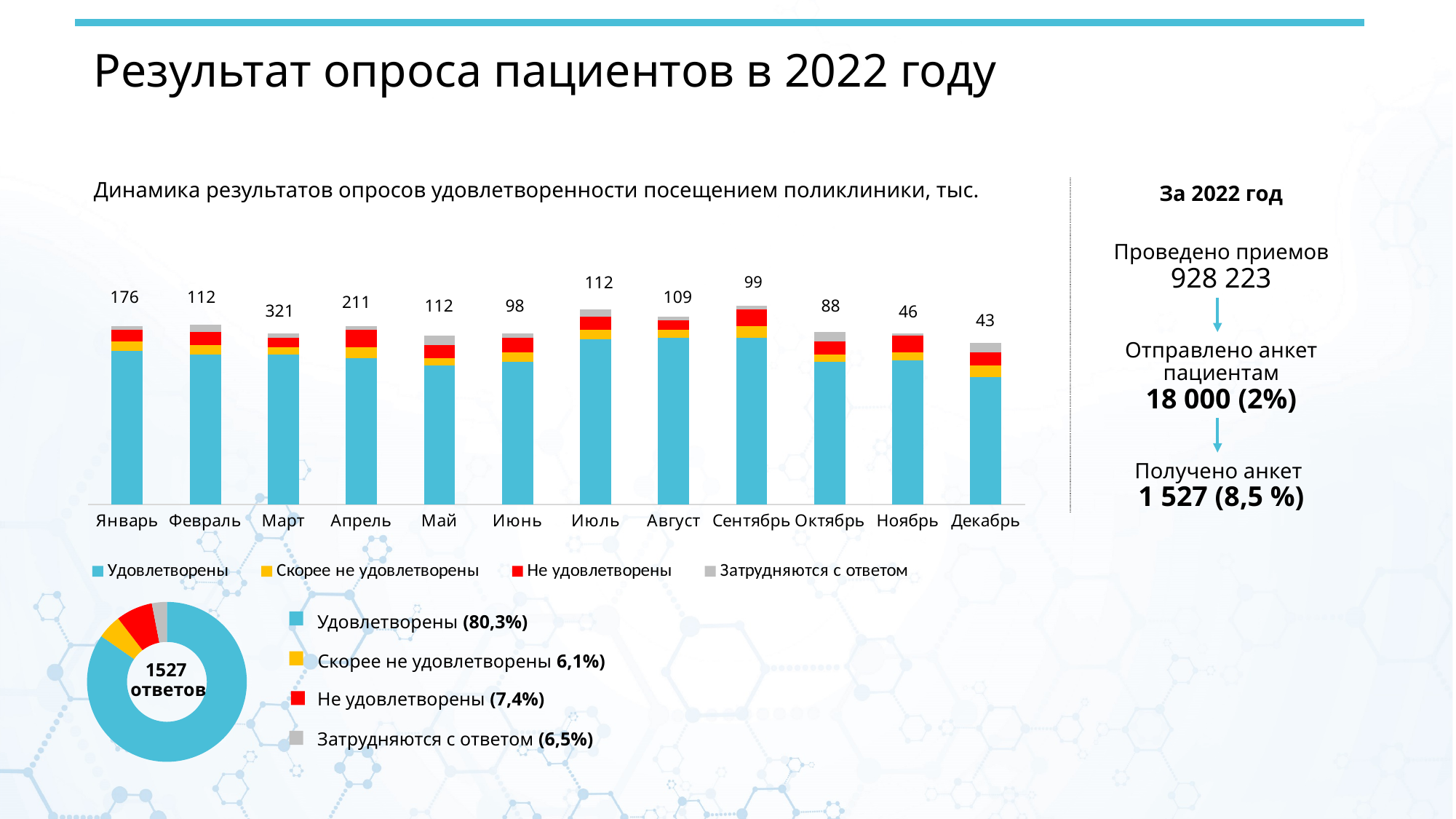
In the donut chart, what share is shown for Удовлетворены? 80,3% In the bar chart, what number is printed above the bar for Сентябрь? 99 How many months are shown on the x axis of the bar chart? 12 In the bar chart, which month has the lowest number printed above its bar? Декабрь In the bar chart, which month has the highest number printed above its bar? Март In the bar chart, what number is printed above the bar for Декабрь? 43 In the bar chart, what number is printed above the bar for Март? 321 In the bar chart, what is the difference between the numbers printed above the bars for Январь and Февраль? 64 In the donut chart, what share is shown for Не удовлетворены? 7,4% What kind of chart is the chart showing the months Январь to Декабрь? Stacked bar chart In the bar chart, which has the larger number printed above its bar, Апрель or Май? Апрель How many series does the legend of the bar chart list? 4